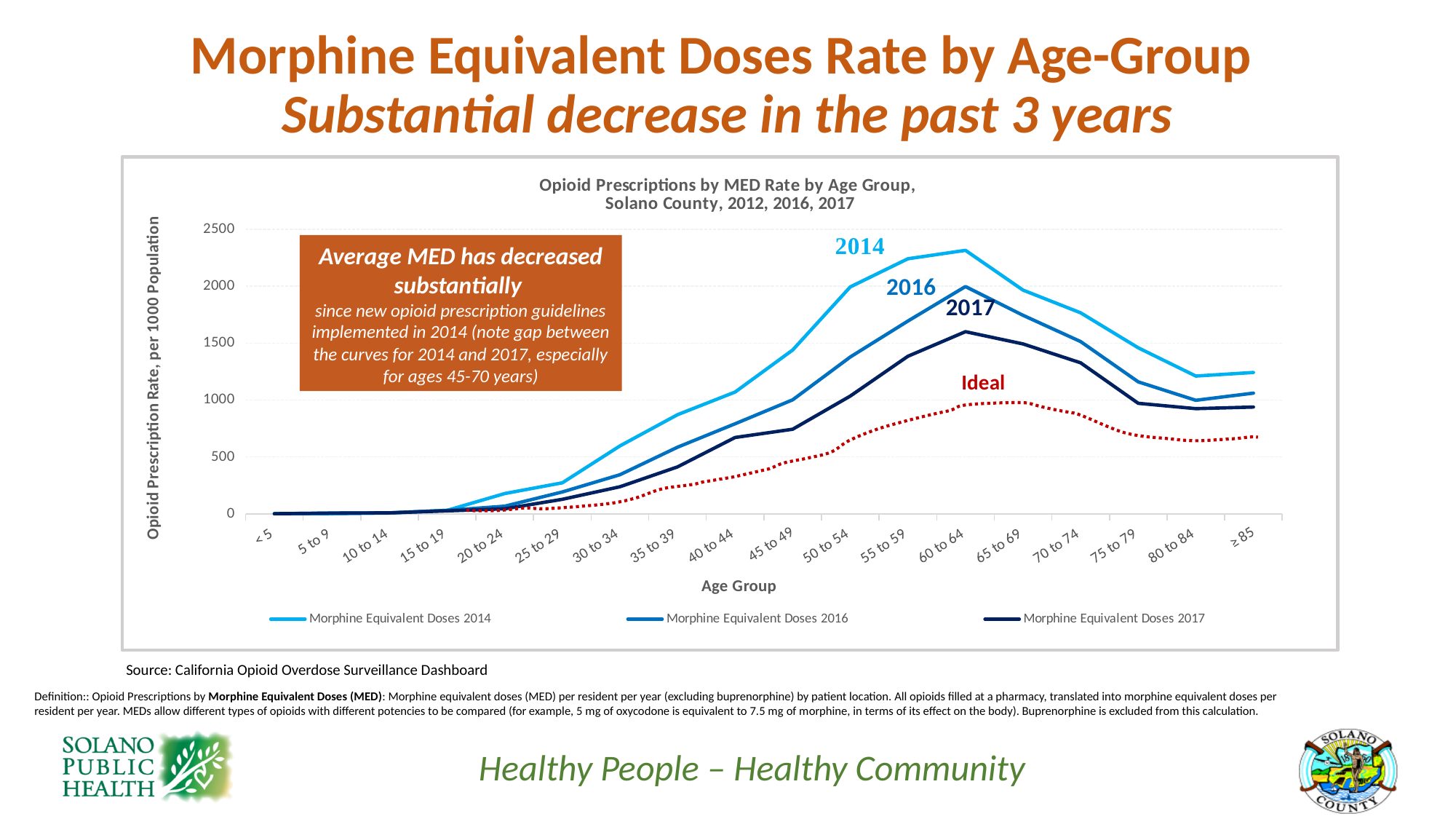
How many age groups are shown on the x axis? 18 Do the Morphine Equivalent Doses 2014 values rise or fall from the 60 to 64 age group to the 80 to 84 age group? Fall Which age group has the highest Morphine Equivalent Doses 2014 rate? 60 to 64 Is the Morphine Equivalent Doses 2017 value for the 60 to 64 age group greater or less than 1000? greater Which age group has the highest Morphine Equivalent Doses 2017 rate? 60 to 64 What is the label of the vertical axis of the chart? Opioid Prescription Rate, per 1000 Population For the 55 to 59 age group, which is larger: the 2014 rate or the 2017 rate? 2014 Is the Morphine Equivalent Doses 2017 value for the 80 to 84 age group greater or less than 1000? less What kind of chart is shown on the slide? Line chart How many series does the chart legend list? 3 Is the Morphine Equivalent Doses 2014 value for the 60 to 64 age group greater or less than 2000? greater